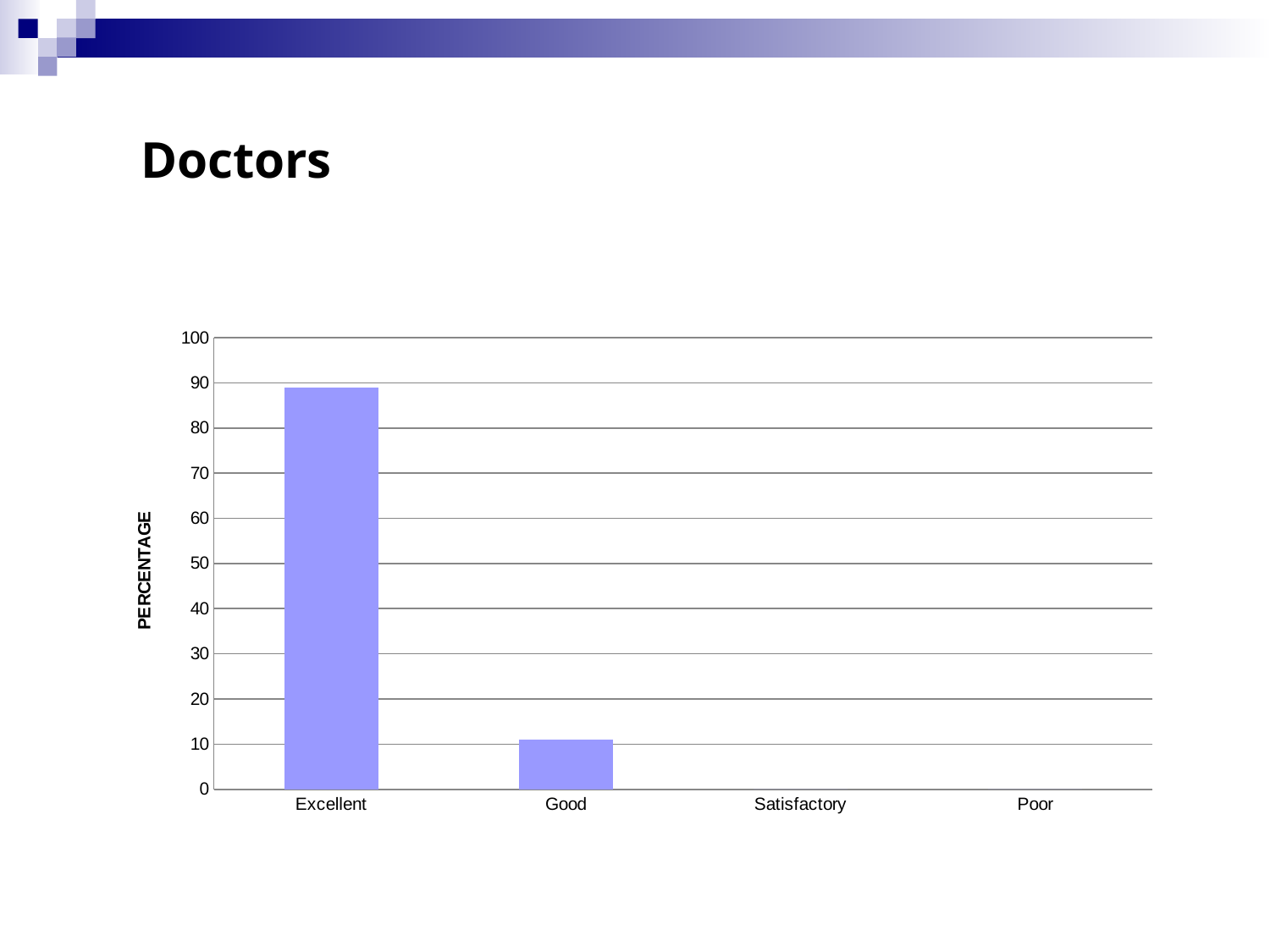
What is the title of the slide containing the chart? Doctors How many categories are shown on the x axis of the chart? 4 Is the value for Good greater or less than 20? less How many categories have a visible bar in the chart? 2 Is the value for Excellent greater or less than 80? greater Do the values rise or fall moving from Excellent to Poor along the x axis? fall Which is larger, the value for Excellent or the value for Good? Excellent What kind of chart is shown on the slide? bar chart What is the label on the vertical axis of the chart? PERCENTAGE Which category has the highest value in the chart? Excellent